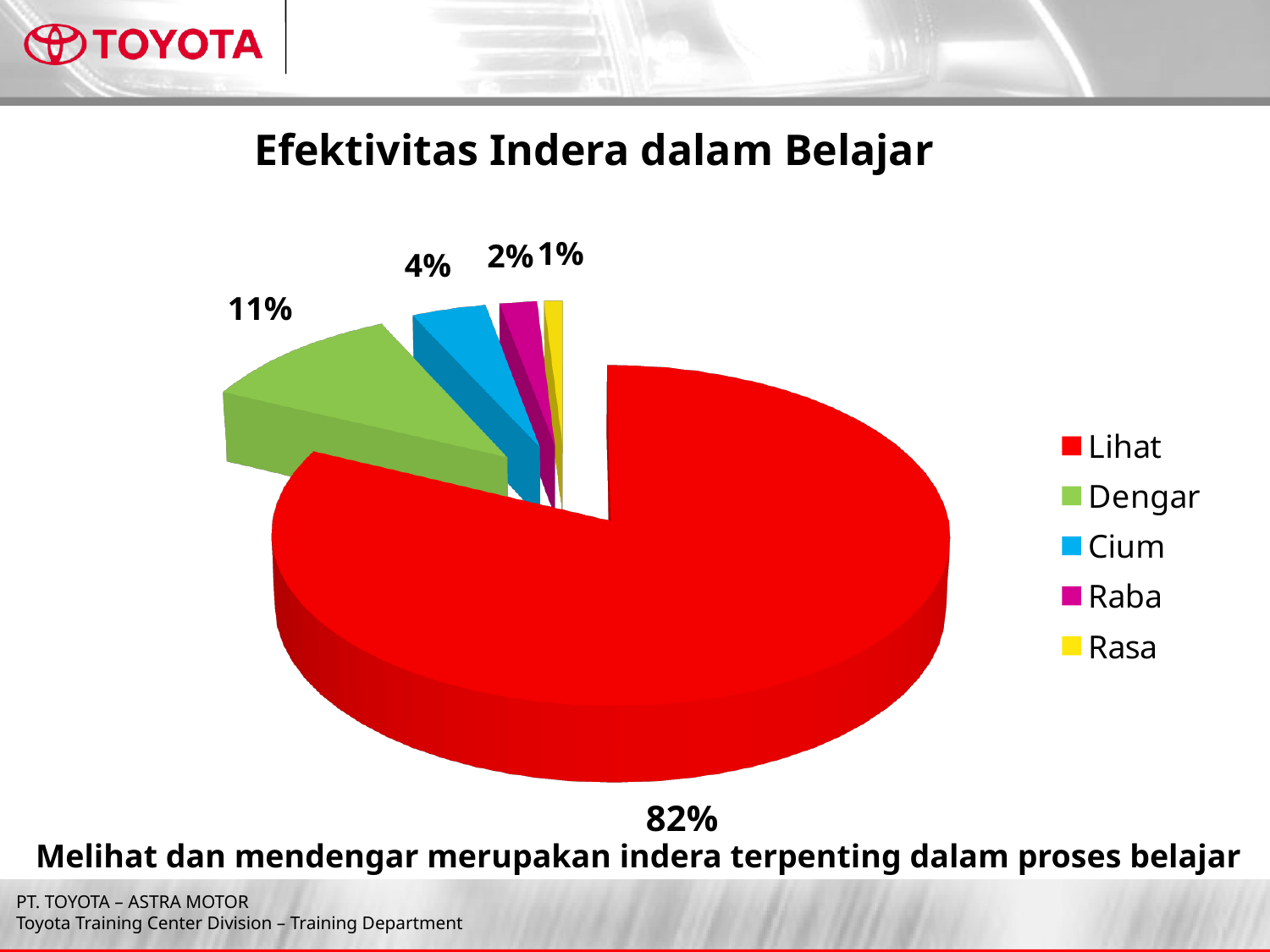
Which category has the largest share of the pie? Lihat What is the value for Lihat? 82% What is the title of the chart? Efektivitas Indera dalam Belajar Which category has the smallest share of the pie? Rasa What is the value for Rasa? 1% Which is larger, the value for Cium or the value for Raba? Cium How many categories does the pie chart have? 5 What type of chart is shown on the slide? pie chart What is the value for Dengar? 11% What is the value for Raba? 2% What is the value for Cium? 4% What is the difference between the values for Lihat and Dengar? 71%